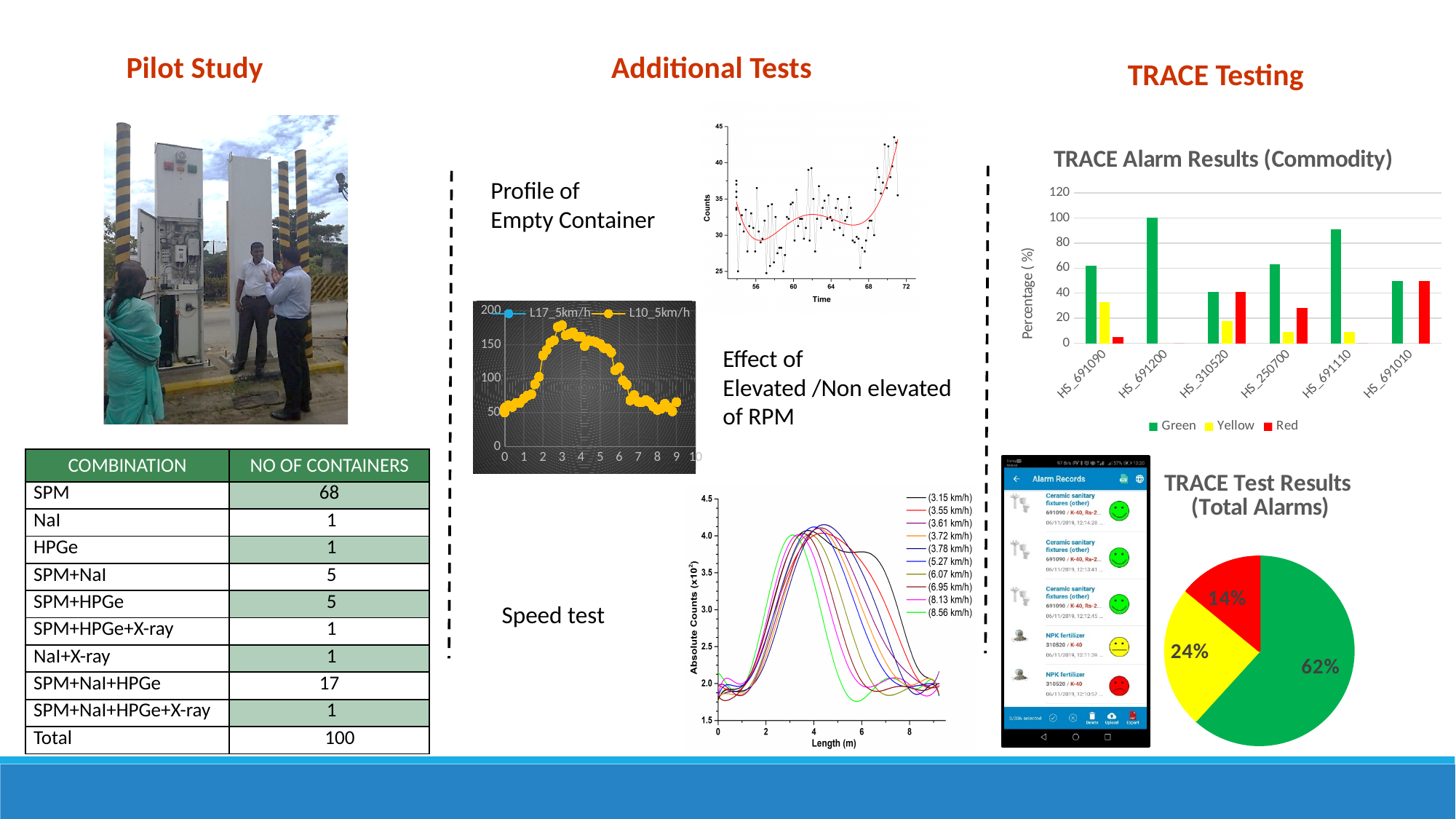
In the TRACE Alarm Results (Commodity) chart, is the Green value for HS_691110 greater or less than 80? greater In the TRACE Test Results (Total Alarms) pie chart, what percentage does the smallest slice show? 14% What kind of chart is the TRACE Alarm Results (Commodity) chart? bar chart In the TRACE Alarm Results (Commodity) chart, which category has the highest Green bar? HS_691200 How many series does the legend of the TRACE Alarm Results (Commodity) chart list? 3 In the TRACE Test Results (Total Alarms) pie chart, what is the difference between the green slice (62%) and the yellow slice (24%)? 38% What are the two series named in the legend of the chart next to 'Effect of Elevated /Non elevated of RPM'? L17_5km/h and L10_5km/h In the TRACE Alarm Results (Commodity) chart, is the Red value for HS_691090 greater or less than 20? less How many series does the legend of the Speed test chart list? 10 In the TRACE Test Results (Total Alarms) pie chart, what percentage does the largest slice show? 62% How many slices does the TRACE Test Results (Total Alarms) pie chart have? 3 How many commodity categories are shown on the x axis of the TRACE Alarm Results (Commodity) chart? 6